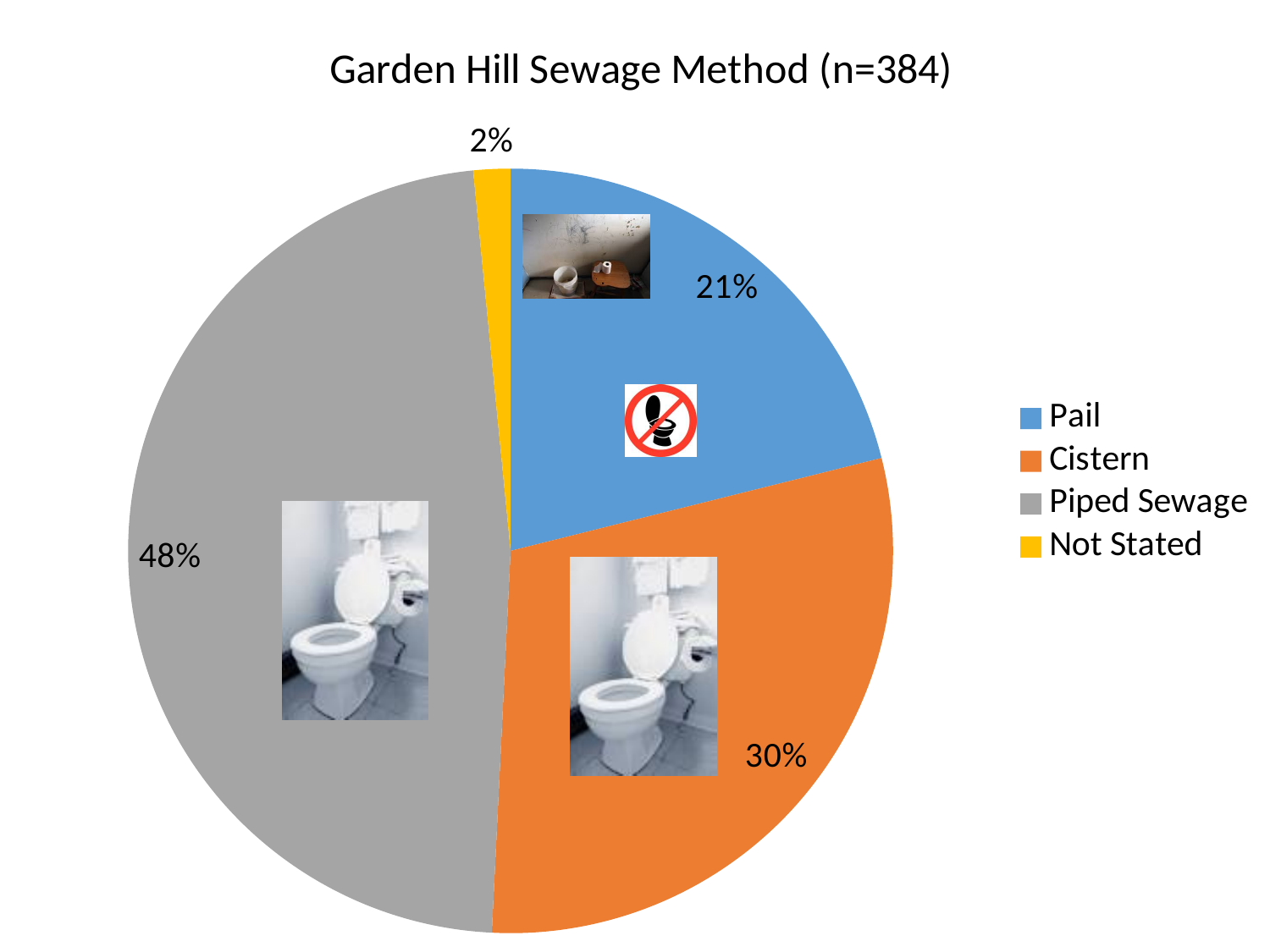
Which is larger, the Pail slice or the Cistern slice? Cistern How many categories does the pie chart show? 4 What is the value shown for Cistern? 30% What is the difference in percentage points between Piped Sewage and Cistern? 18 What kind of chart is shown on the slide? Pie chart Which category has the largest slice of the pie? Piped Sewage What is the title of the chart? Garden Hill Sewage Method (n=384) What is the value shown for Not Stated? 2% What is the value shown for Pail? 21% What is the difference in percentage points between Cistern and Pail? 9 Which category has the smallest slice of the pie? Not Stated What share of the pie does Piped Sewage represent? 48%